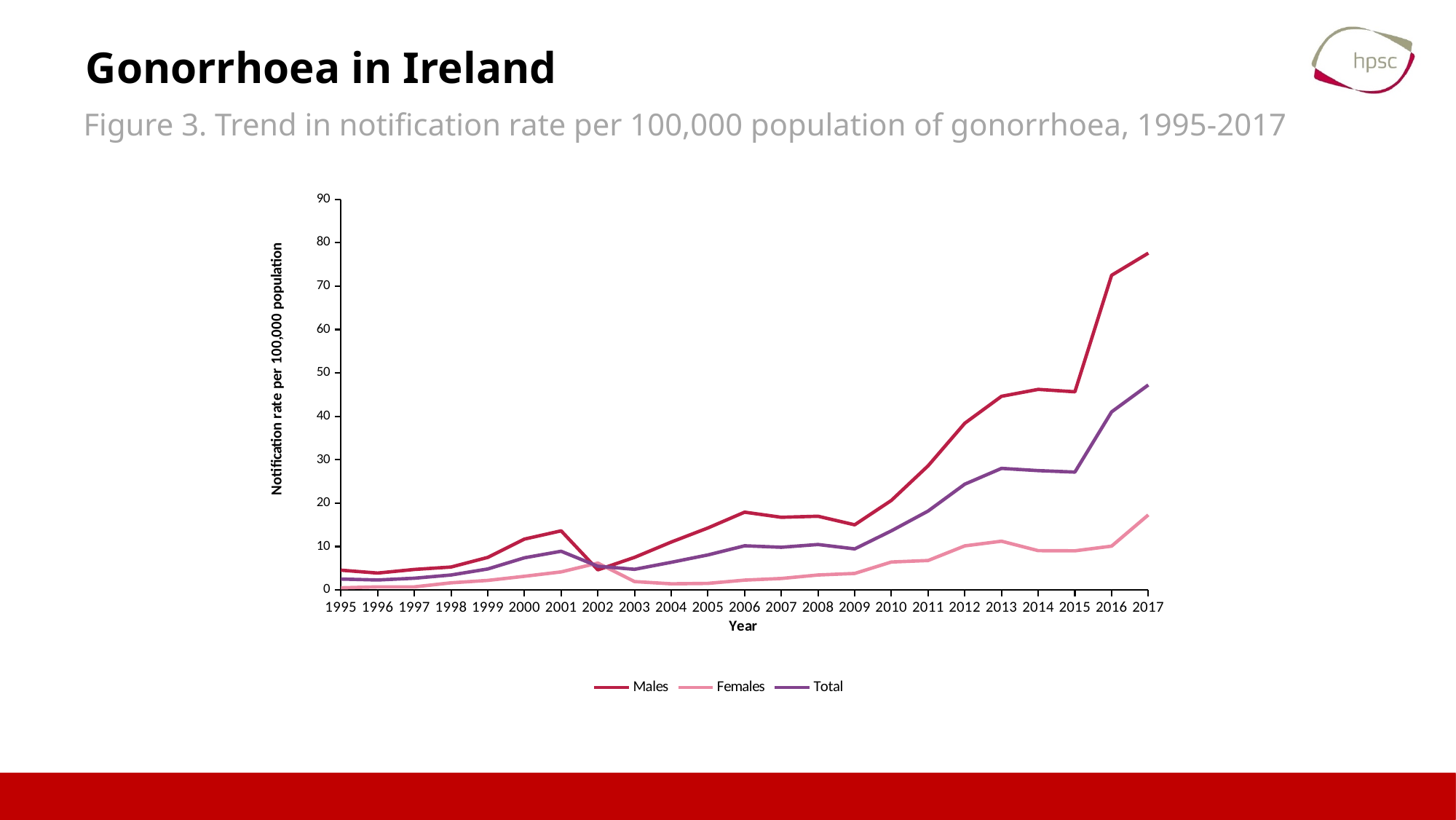
How many series does the legend list? 3 Is the value for Females in 2017 greater or less than 20? less Which is larger in 2010, the value for Total or the value for Females? Total How many years are plotted along the x axis? 23 Is the value for Males in 2017 greater or less than 70? greater Is the value for Males in 2013 greater or less than 40? greater What is the label on the y axis? Notification rate per 100,000 population In which year does the Males series reach its highest value? 2017 Does the Males series rise or fall between 2015 and 2017? rise Which series has the highest notification rate in 2017? Males What kind of chart is shown on the slide? line chart